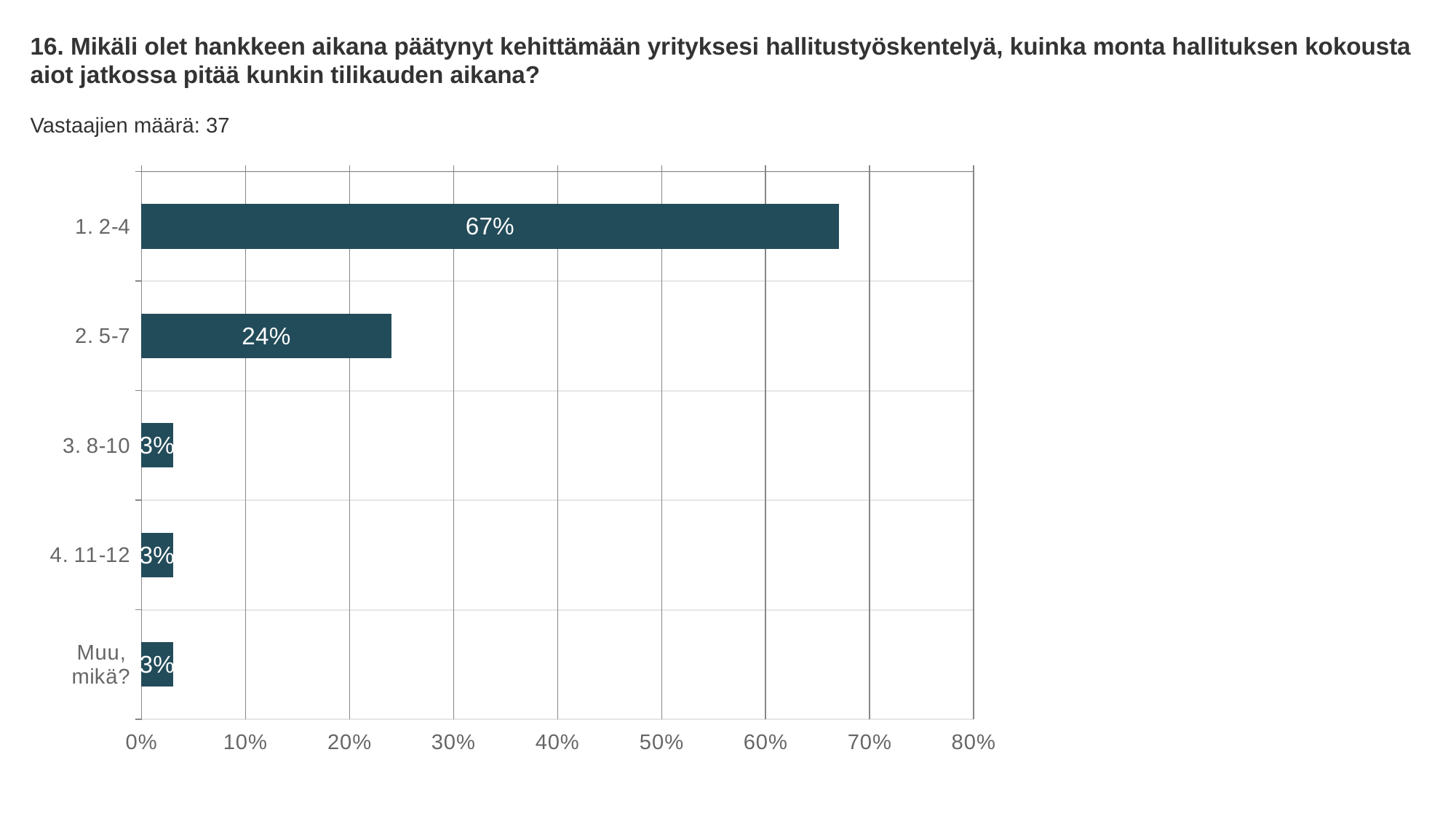
Which category has the highest value? 1. 2-4 How many respondents (Vastaajien määrä) are reported on the slide? 37 What is the value for the category "1. 2-4"? 67% What is the value for the category "Muu, mikä?"? 3% What is the difference between the values for "2. 5-7" and "4. 11-12"? 21% What is the value for the category "3. 8-10"? 3% What kind of chart is shown on the slide? bar chart What is the value for the category "2. 5-7"? 24% What is the difference between the values for "1. 2-4" and "2. 5-7"? 43% How many categories are shown in the chart? 5 Which is larger, the value for "2. 5-7" or the value for "3. 8-10"? 2. 5-7 Is the value for "1. 2-4" greater or less than 60%? greater